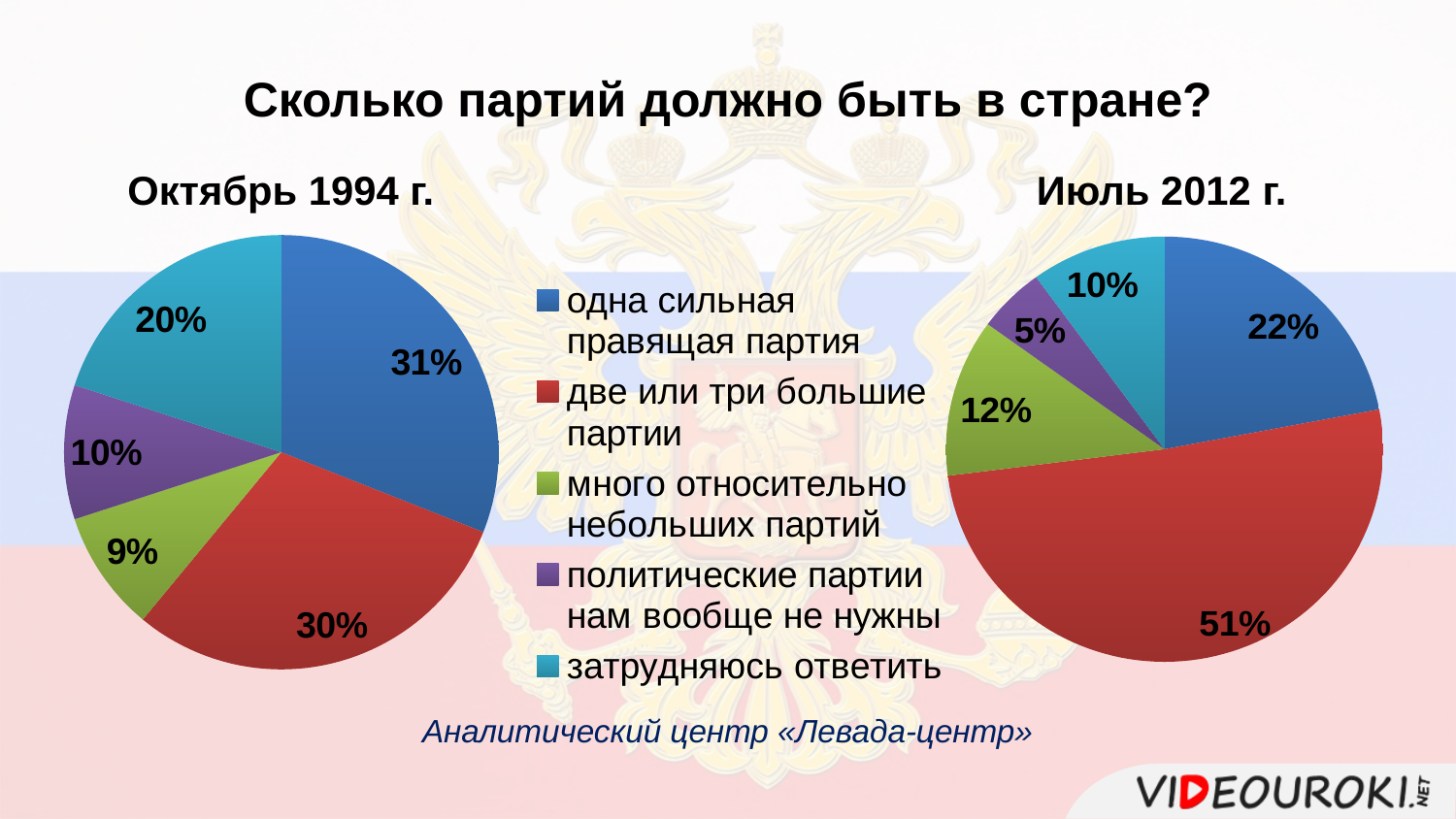
In the "Июль 2012 г." chart, which category has the smallest slice? политические партии нам вообще не нужны In the "Октябрь 1994 г." chart, what share is shown for "затрудняюсь ответить"? 20% In the "Июль 2012 г." chart, what share is shown for "две или три большие партии"? 51% In the "Июль 2012 г." chart, which category has the largest slice? две или три большие партии What is the difference between the share for "две или три большие партии" in the "Июль 2012 г." chart and in the "Октябрь 1994 г." chart? 21% What type of chart is used on the slide for "Октябрь 1994 г."? pie chart In the "Октябрь 1994 г." chart, which category has the smallest slice? много относительно небольших партий How many categories does the legend list for the pie charts? 5 What colour represents "затрудняюсь ответить" in the pie charts? teal (light blue) In the "Июль 2012 г." chart, what share is shown for "политические партии нам вообще не нужны"? 5% Which is larger: the share for "много относительно небольших партий" in the "Октябрь 1994 г." chart or in the "Июль 2012 г." chart? Июль 2012 г. In the "Октябрь 1994 г." chart, what share is shown for "одна сильная правящая партия"? 31%